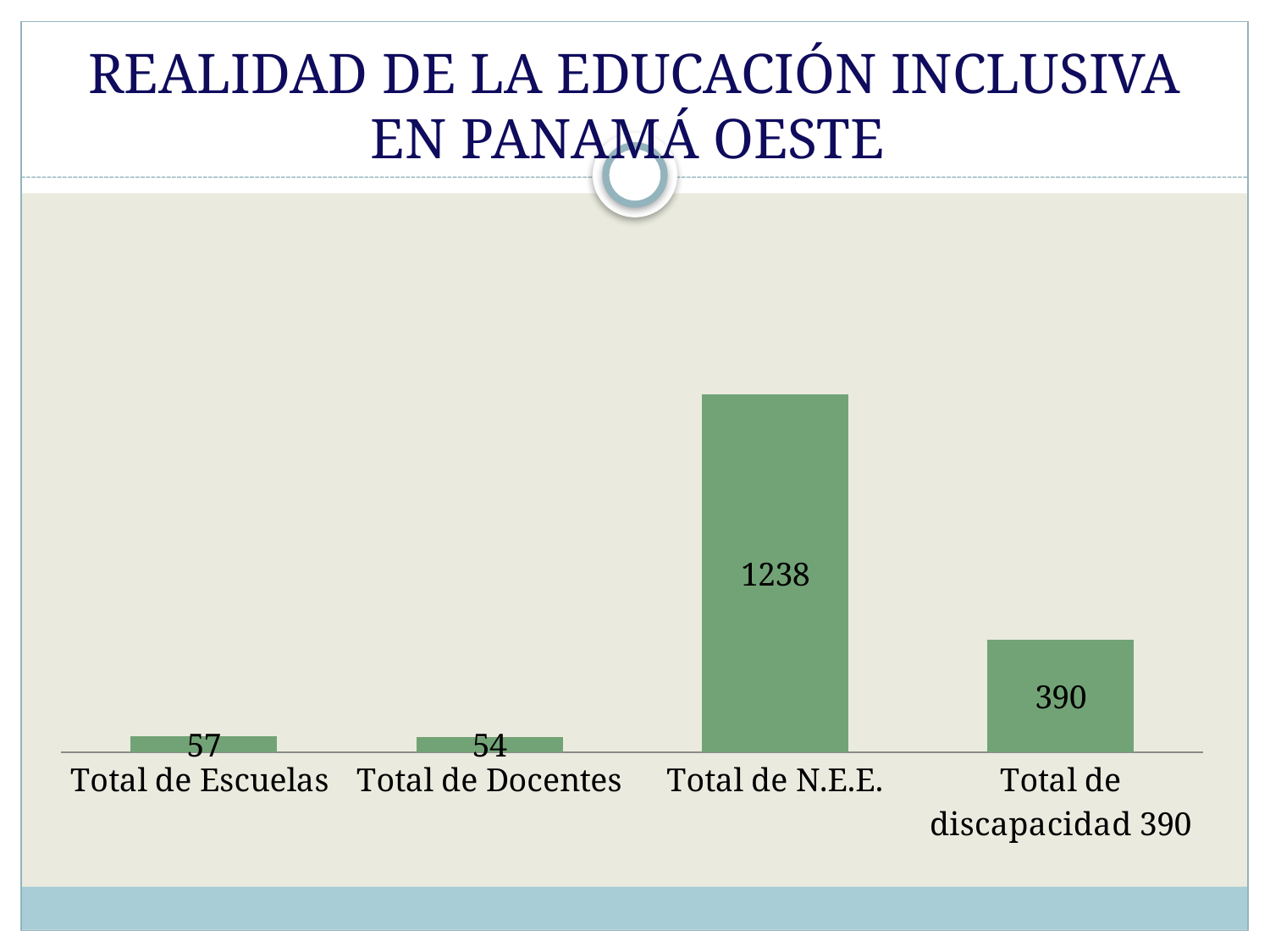
Which is larger, Total de discapacidad 390 or Total de Escuelas? Total de discapacidad 390 What is the value for Total de N.E.E.? 1238 What is the value for Total de Escuelas? 57 Which category has the lowest value? Total de Docentes What kind of chart is shown on the slide? bar chart What is the value for Total de Docentes? 54 Which category has the highest value? Total de N.E.E. How many categories are shown in the chart? 4 What is the difference between Total de Escuelas and Total de Docentes? 3 What is the difference between Total de N.E.E. and Total de discapacidad 390? 848 What is the title of the slide containing the chart? REALIDAD DE LA EDUCACIÓN INCLUSIVA EN PANAMÁ OESTE What is the value for Total de discapacidad 390? 390